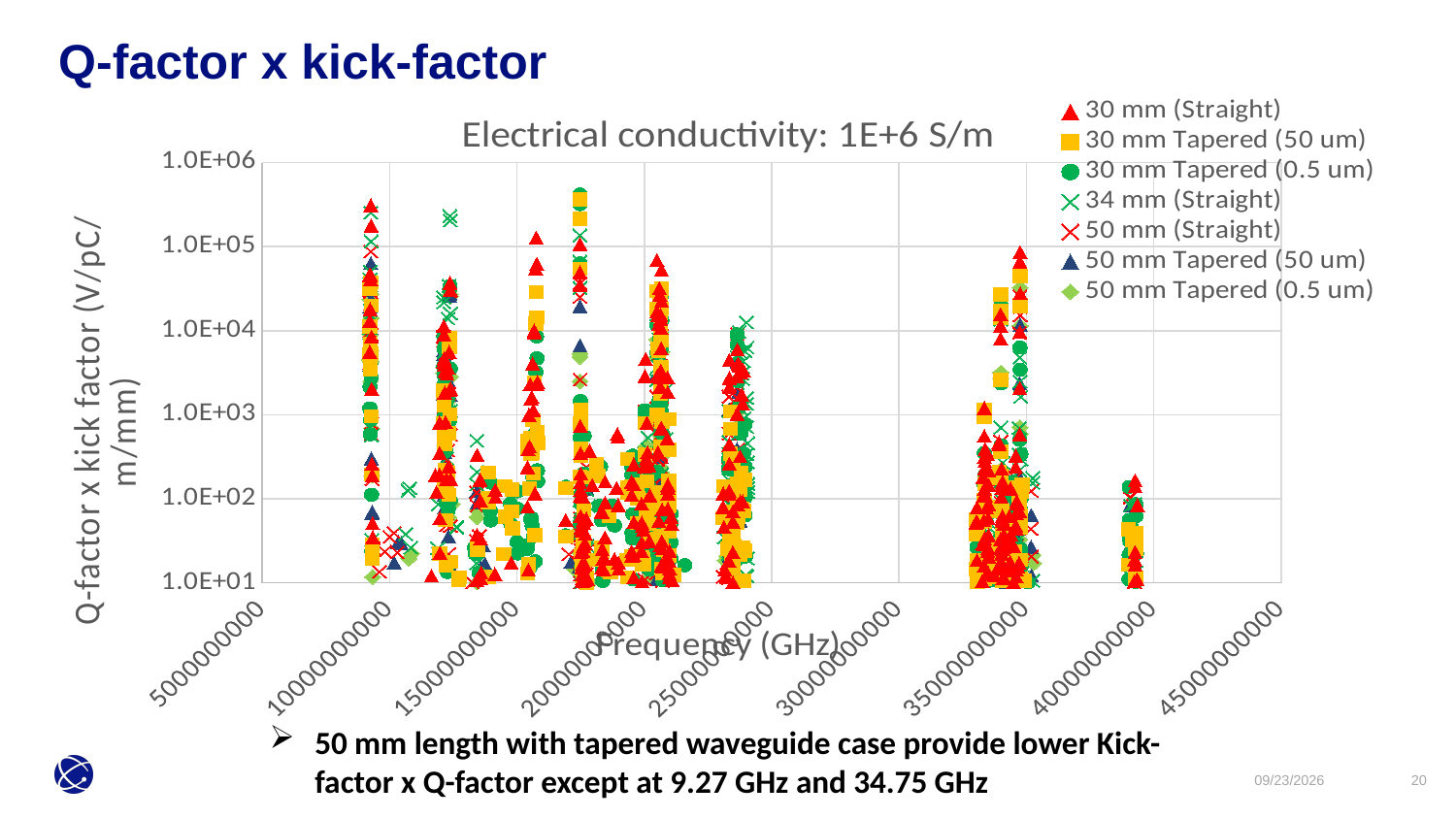
What is the label of the y axis? Q-factor x kick factor (V/pC/m/mm) Is the highest value plotted on the chart greater or less than 1.0E+05? greater What is the title of the chart? Electrical conductivity: 1E+6 S/m What kind of chart is shown on the slide? Scatter chart Is the highest value plotted on the chart greater or less than 1.0E+06? less How many series does the legend list? 7